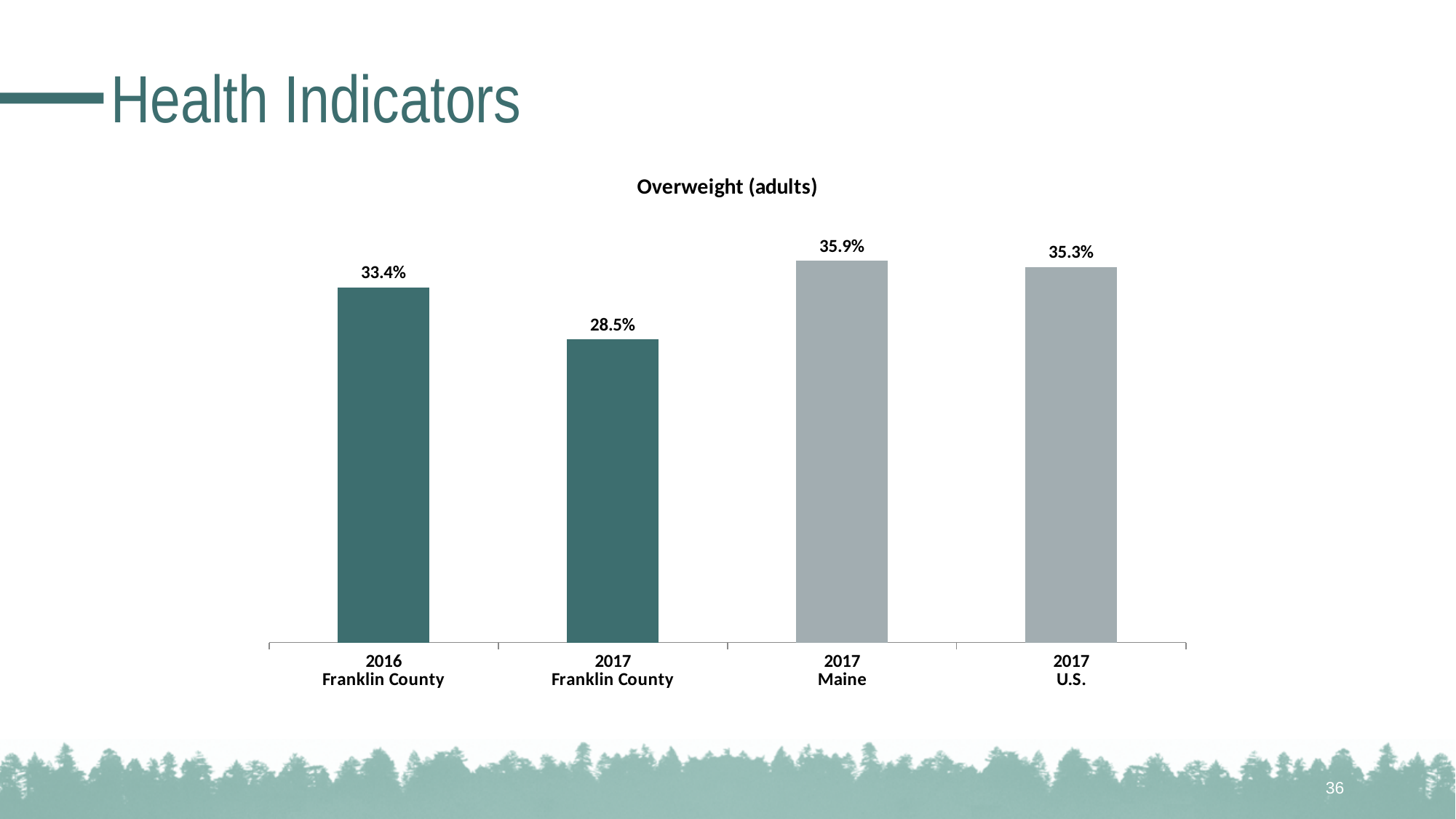
Which is larger, the overweight (adults) value for 2017 Franklin County or for 2017 U.S.? 2017 U.S. What is the overweight (adults) value for 2017 Maine? 35.9% What is the difference between the 2016 Franklin County and 2017 Franklin County overweight (adults) values? 4.9% What is the overweight (adults) value for 2017 U.S.? 35.3% What kind of chart is shown on the slide? Bar chart What is the overweight (adults) value for 2017 Franklin County? 28.5% What is the difference between the 2017 Maine and 2017 U.S. overweight (adults) values? 0.6% What is the title of the chart on the slide? Overweight (adults) Which category has the lowest overweight (adults) value? 2017 Franklin County What is the overweight (adults) value for 2016 Franklin County? 33.4% Which category has the highest overweight (adults) value? 2017 Maine How many categories are shown in the Overweight (adults) chart? 4